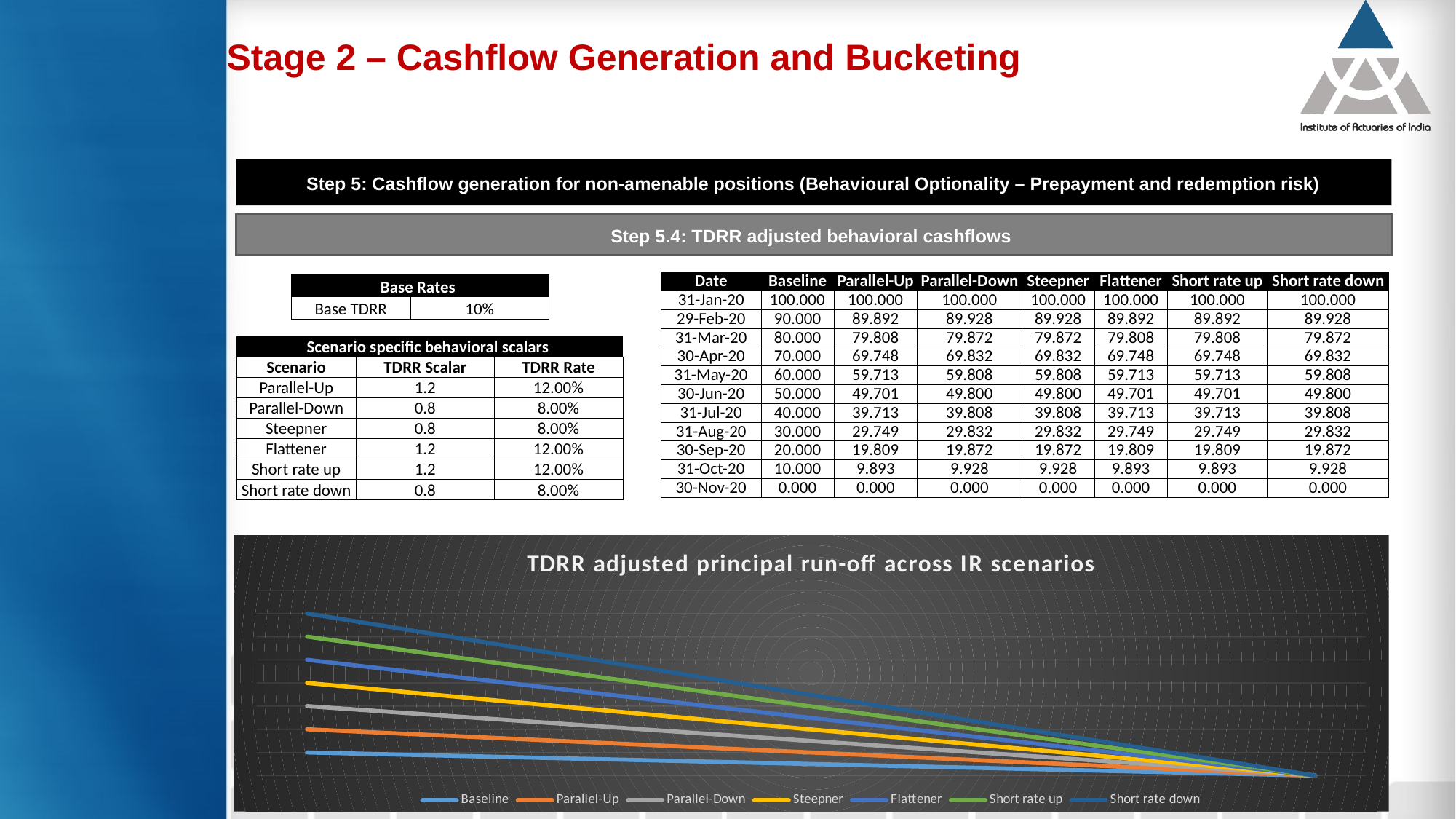
Do the plotted lines in the chart rise or fall from left to right? fall What is the title of the chart at the bottom of the slide? TDRR adjusted principal run-off across IR scenarios How many series does the chart legend list? 7 Which series is listed first in the chart legend? Baseline Do all the series in the chart converge to the same point at the right end? yes